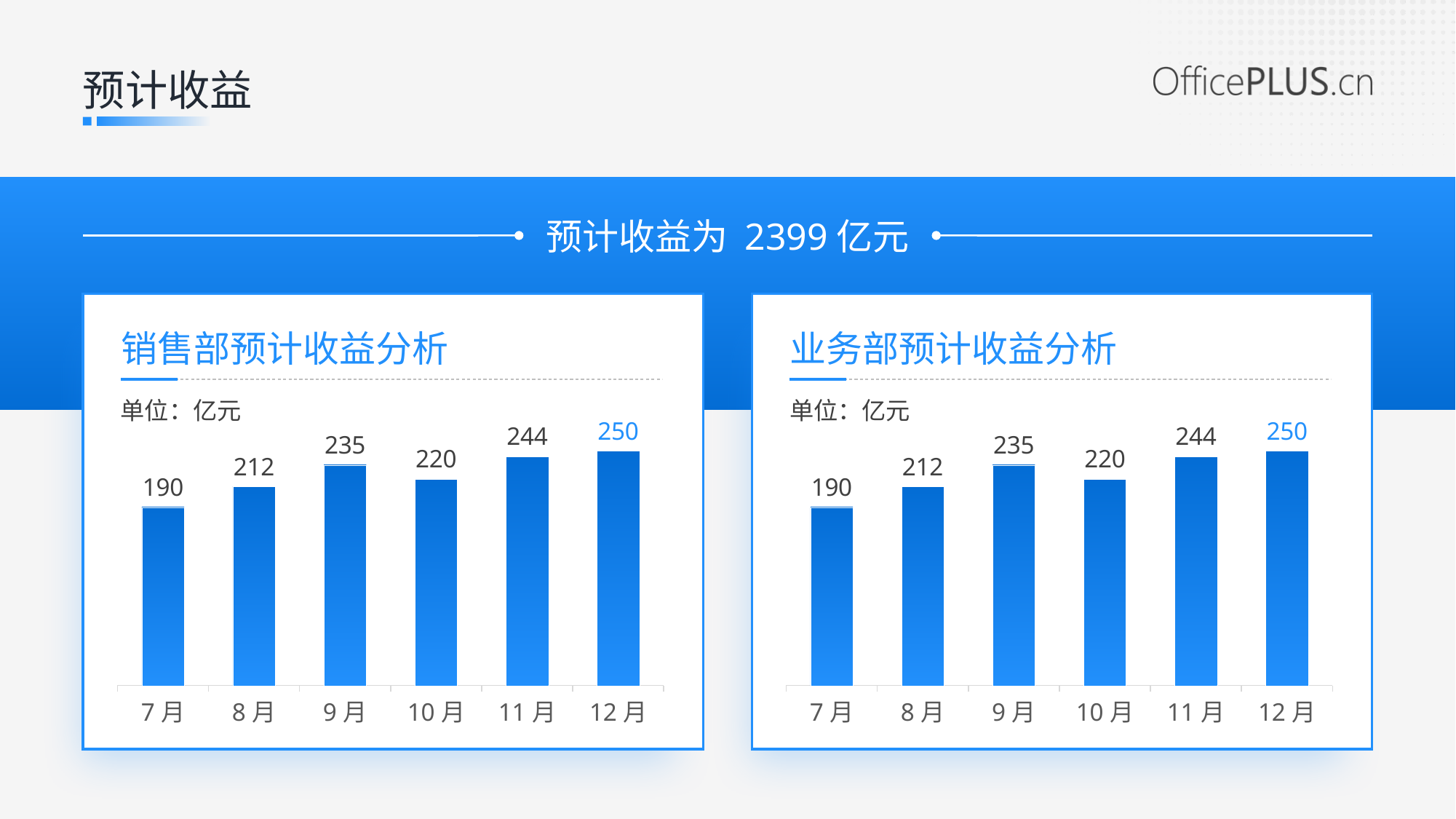
In the 销售部预计收益分析 chart, which is larger, the value for 9月 or the value for 10月? 9月 In the 业务部预计收益分析 chart, what is the value for 10月? 220 How many months are shown in the 业务部预计收益分析 chart? 6 In the 销售部预计收益分析 chart, what is the difference between the values for 12月 and 7月? 60 What kind of chart is the 销售部预计收益分析 chart? bar chart What unit is stated for the values in the 业务部预计收益分析 chart? 亿元 In the 销售部预计收益分析 chart, what is the value for 8月? 212 In the 业务部预计收益分析 chart, which month has the lowest value? 7月 In the 销售部预计收益分析 chart, what is the value for 9月? 235 In the 销售部预计收益分析 chart, which month has the highest value? 12月 In the 业务部预计收益分析 chart, what is the difference between the values for 11月 and 10月? 24 In the 业务部预计收益分析 chart, does the value rise or fall from 9月 to 10月? fall